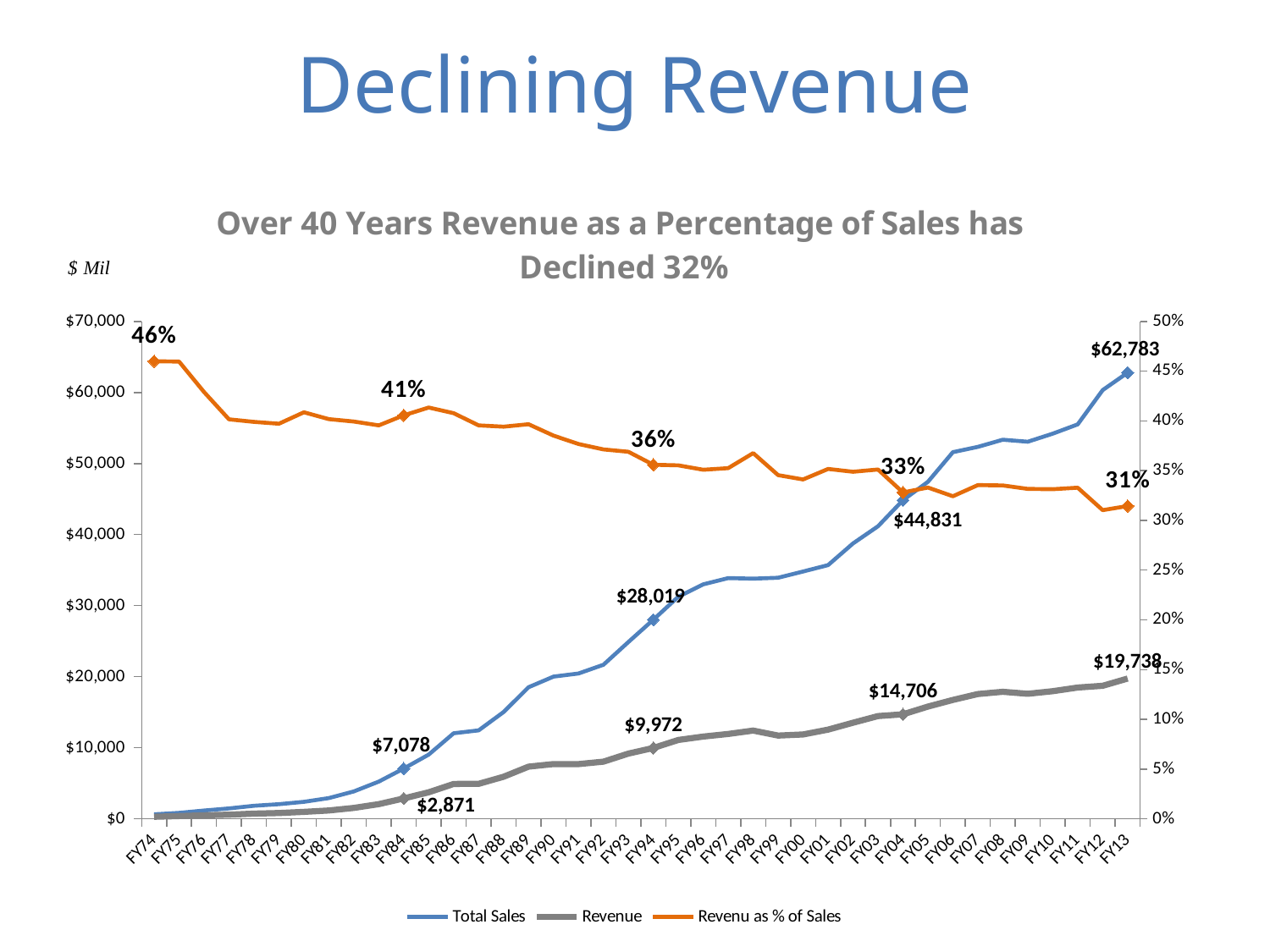
What is the difference between Revenue in FY13 and FY04? $5,032 What is the Revenue value for FY04? $14,706 Does Revenue as % of Sales generally rise or fall from FY74 to FY13? Fall What is Revenue as % of Sales in FY84? 41% By how many percentage points did Revenue as % of Sales fall from FY74 to FY13? 15 percentage points How many series does the legend list? 3 What is the difference between Total Sales in FY13 and FY04? $17,952 What is the Total Sales value for FY13? $62,783 What kind of chart is shown on the slide? Line chart What is the Revenue value for FY84? $2,871 Which is larger, Revenue in FY94 or Revenue in FY84? FY94 Is Total Sales in FY99 greater or less than $30,000? greater